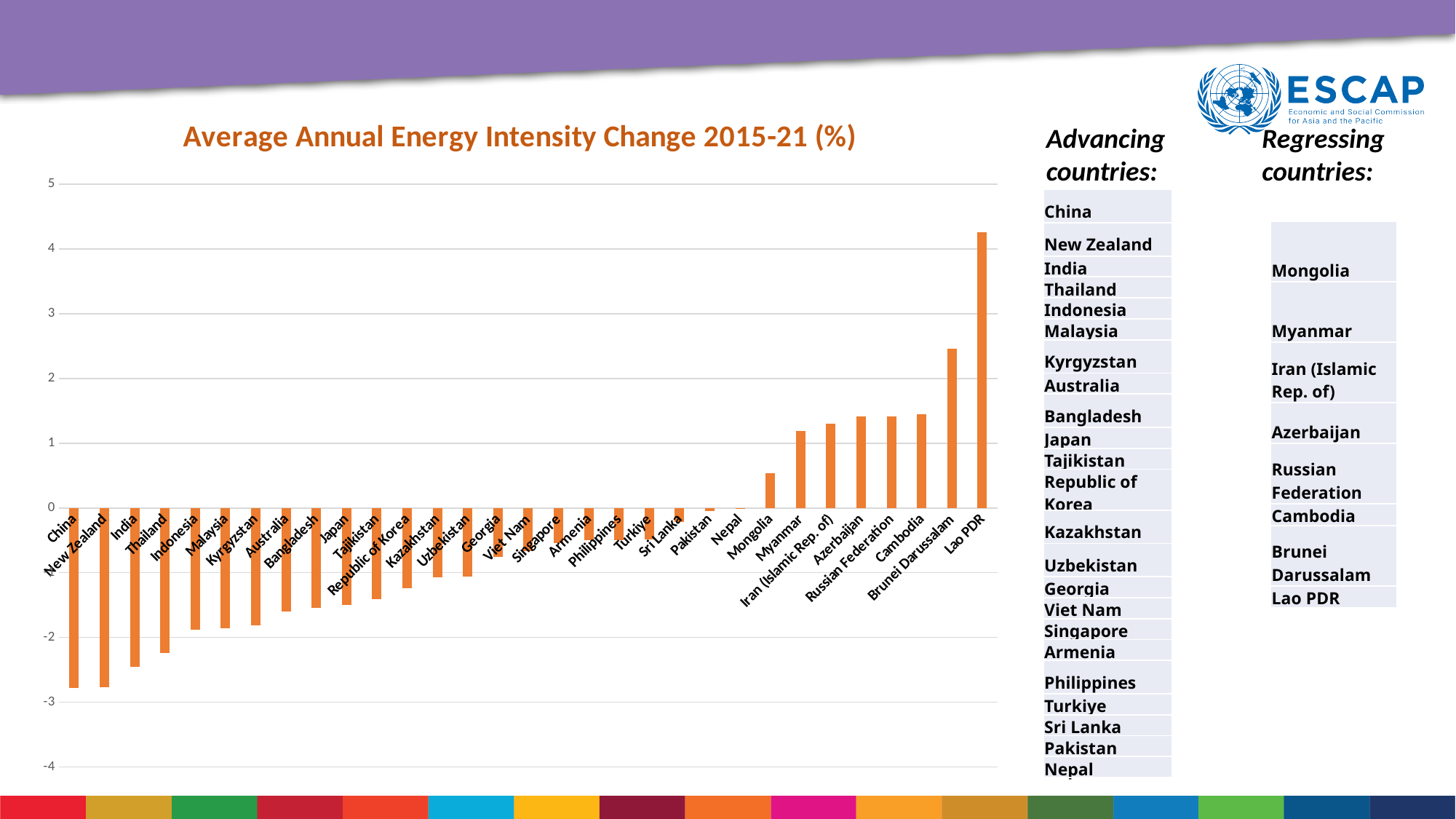
Is the value for Japan greater or less than -1? less How many countries are plotted on the chart? 31 Is the value for India greater or less than -2? less Do the values rise or fall moving from left to right along the x axis? rise Is the value for Brunei Darussalam greater or less than 2? greater Which has the larger value, Mongolia or Myanmar? Myanmar What kind of chart is shown on the slide? bar chart Which country has the highest average annual energy intensity change on the chart? Lao PDR What is the title of the chart? Average Annual Energy Intensity Change 2015-21 (%) Which has the larger value, Lao PDR or Brunei Darussalam? Lao PDR